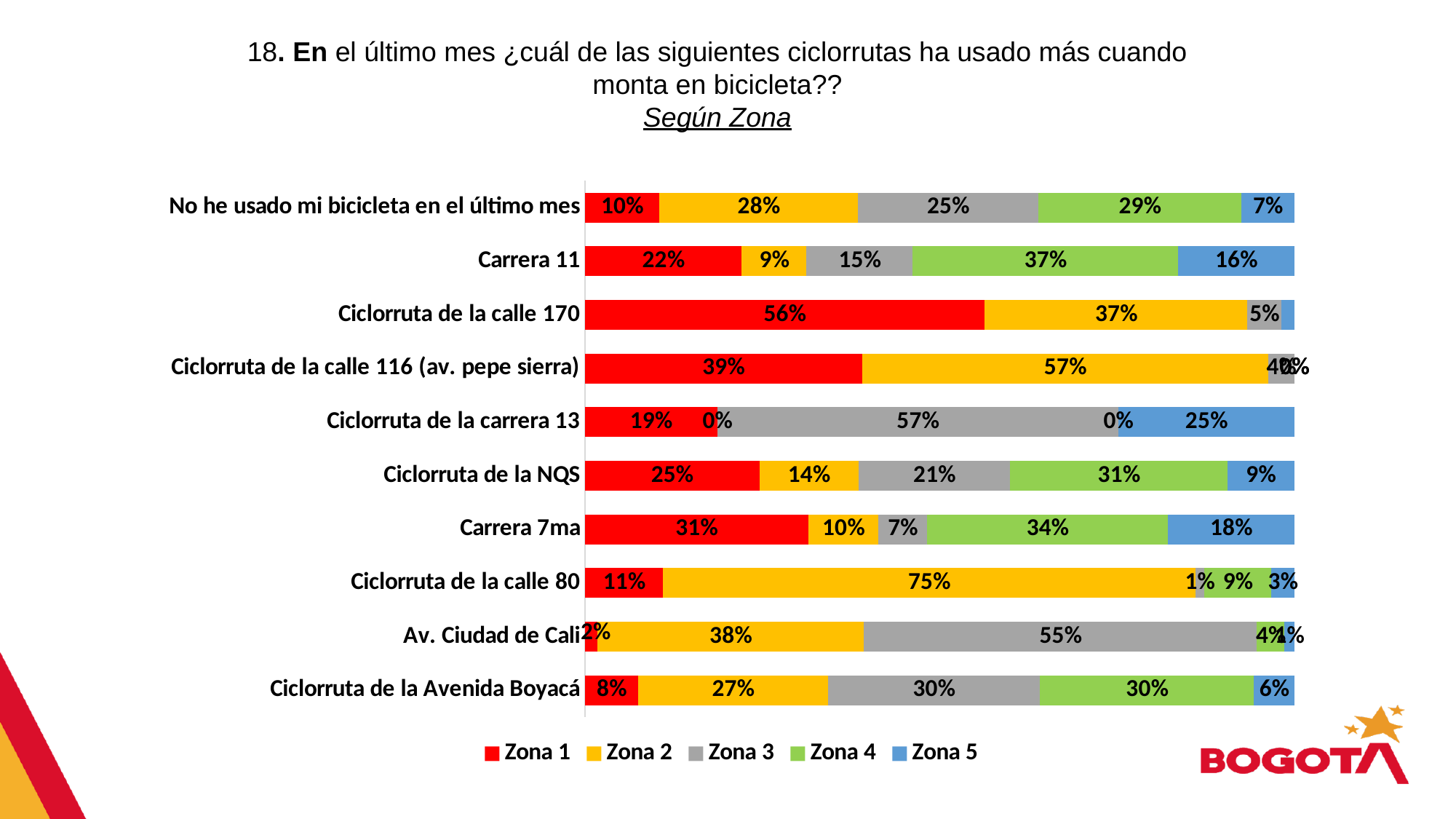
What is the Zona 2 value for Ciclorruta de la calle 80? 75% What is the Zona 1 value for Ciclorruta de la calle 170? 56% How many series does the legend list? 5 What is the Zona 3 value for Ciclorruta de la carrera 13? 57% What is the Zona 4 value for Carrera 11? 37% For Ciclorruta de la NQS, which is larger: the Zona 4 value or the Zona 1 value? Zona 4 How many ciclorruta categories are plotted on the chart? 10 What is the Zona 5 value for Ciclorruta de la Avenida Boyacá? 6% Which category has the highest Zona 1 value? Ciclorruta de la calle 170 What kind of chart is shown on the slide? Stacked bar chart For Carrera 7ma, what is the difference between the Zona 4 value and the Zona 1 value? 3 percentage points Which category has the highest Zona 2 value? Ciclorruta de la calle 80